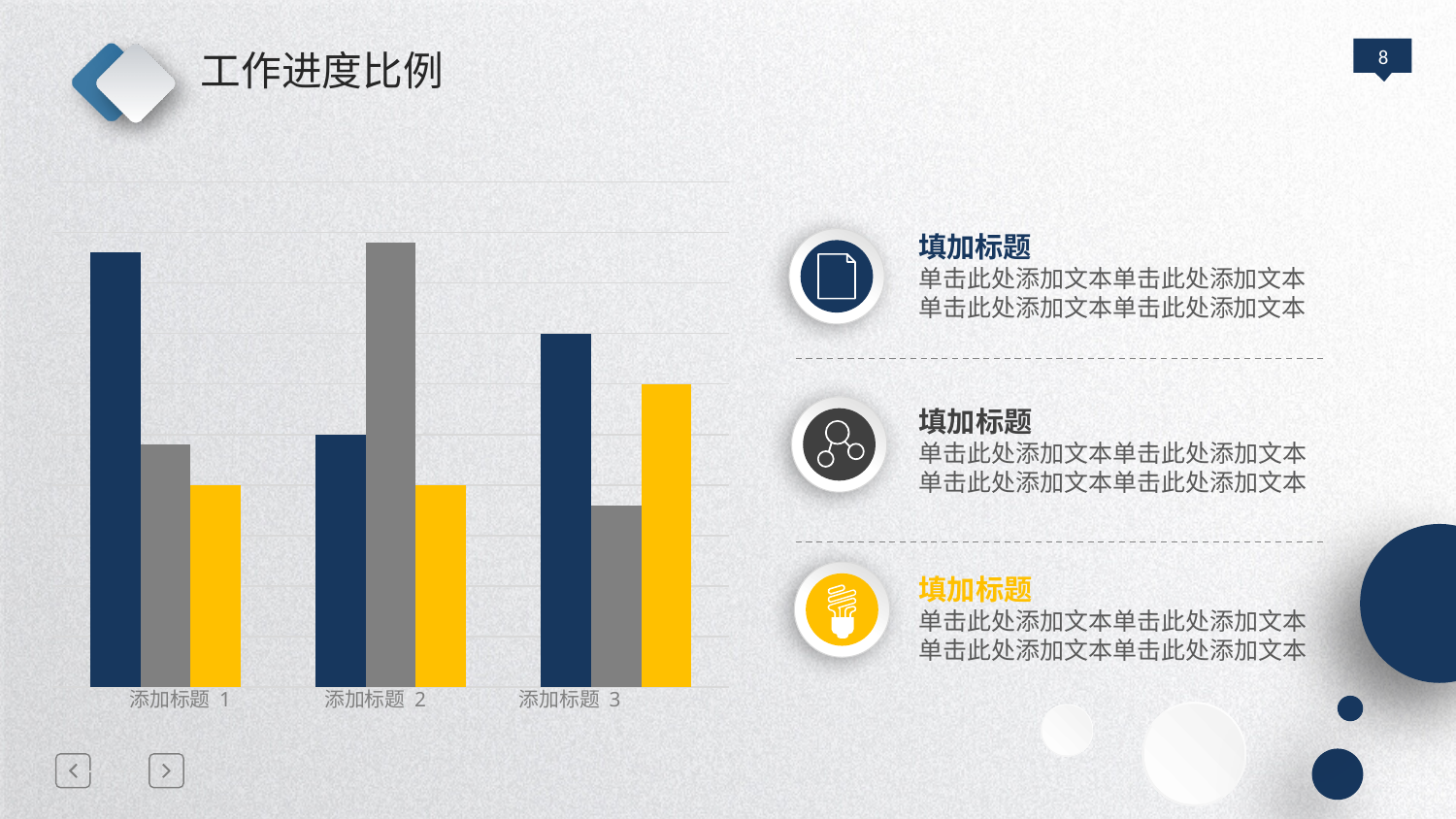
Which category has the shortest dark blue bar? 添加标题 2 In category 添加标题 1, which bar is the tallest? The dark blue bar Which category has the tallest gray bar? 添加标题 2 What kind of chart is shown on the slide? Bar chart Which category has the shortest gray bar? 添加标题 3 In category 添加标题 3, is the dark blue bar or the gray bar taller? The dark blue bar In category 添加标题 2, is the gray bar or the yellow bar taller? The gray bar How many bars are plotted for each category in the chart? 3 How many categories are shown on the x axis of the chart? 3 What colours are the three bars in each category of the chart? Dark blue, gray and yellow Which category has the tallest yellow bar? 添加标题 3